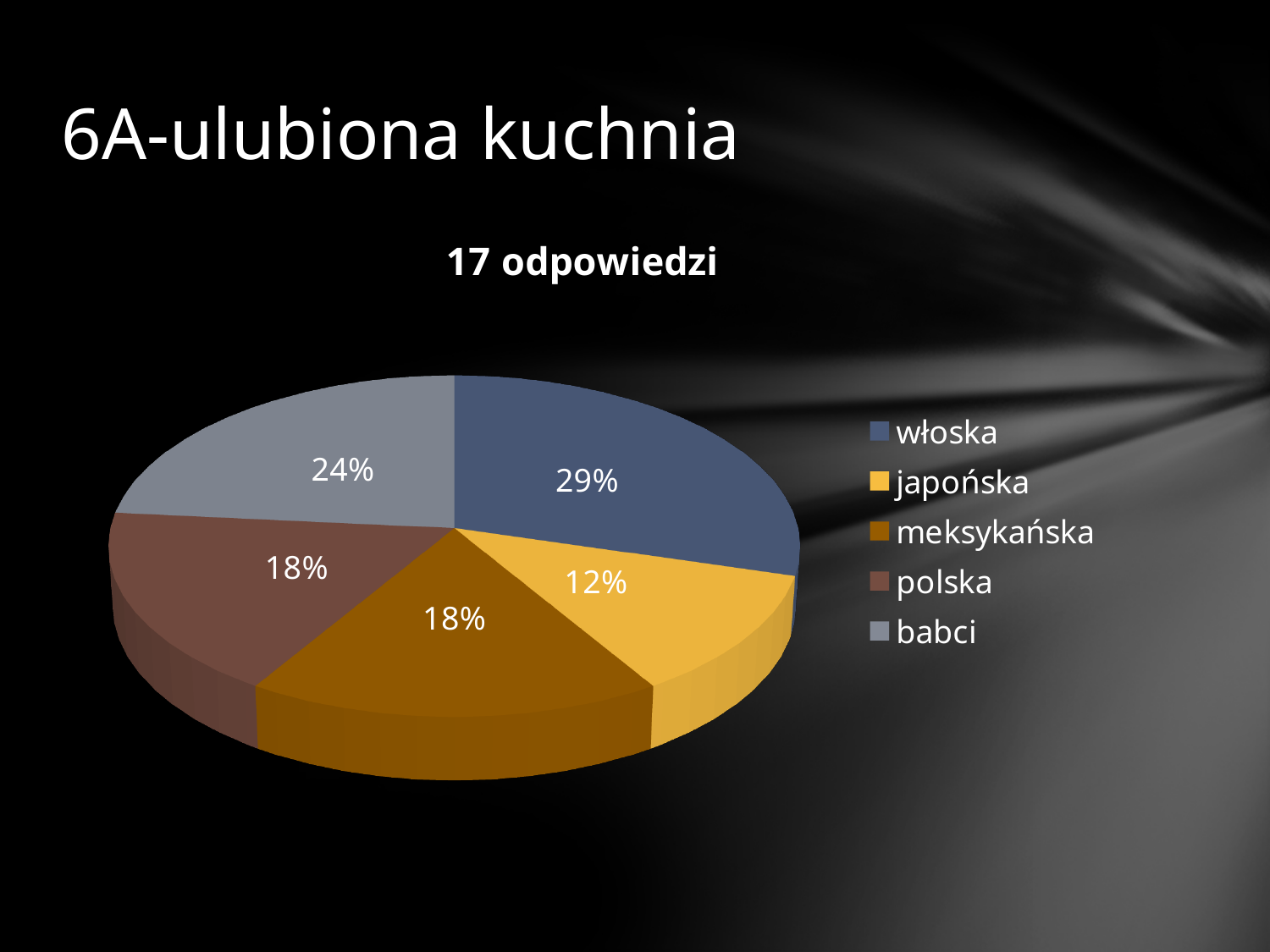
Which category has the smallest slice of the pie? japońska What share of the pie does babci have? 24% What kind of chart is shown on the slide? pie chart What share of the pie does polska have? 18% How many categories does the pie chart show? 5 Which is larger, the share for babci or the share for meksykańska? babci What share of the pie does włoska have? 29% What is the title of the chart? 17 odpowiedzi What is the difference in percentage points between babci and polska? 6 Which category has the largest slice of the pie? włoska What is the difference in percentage points between włoska and japońska? 17